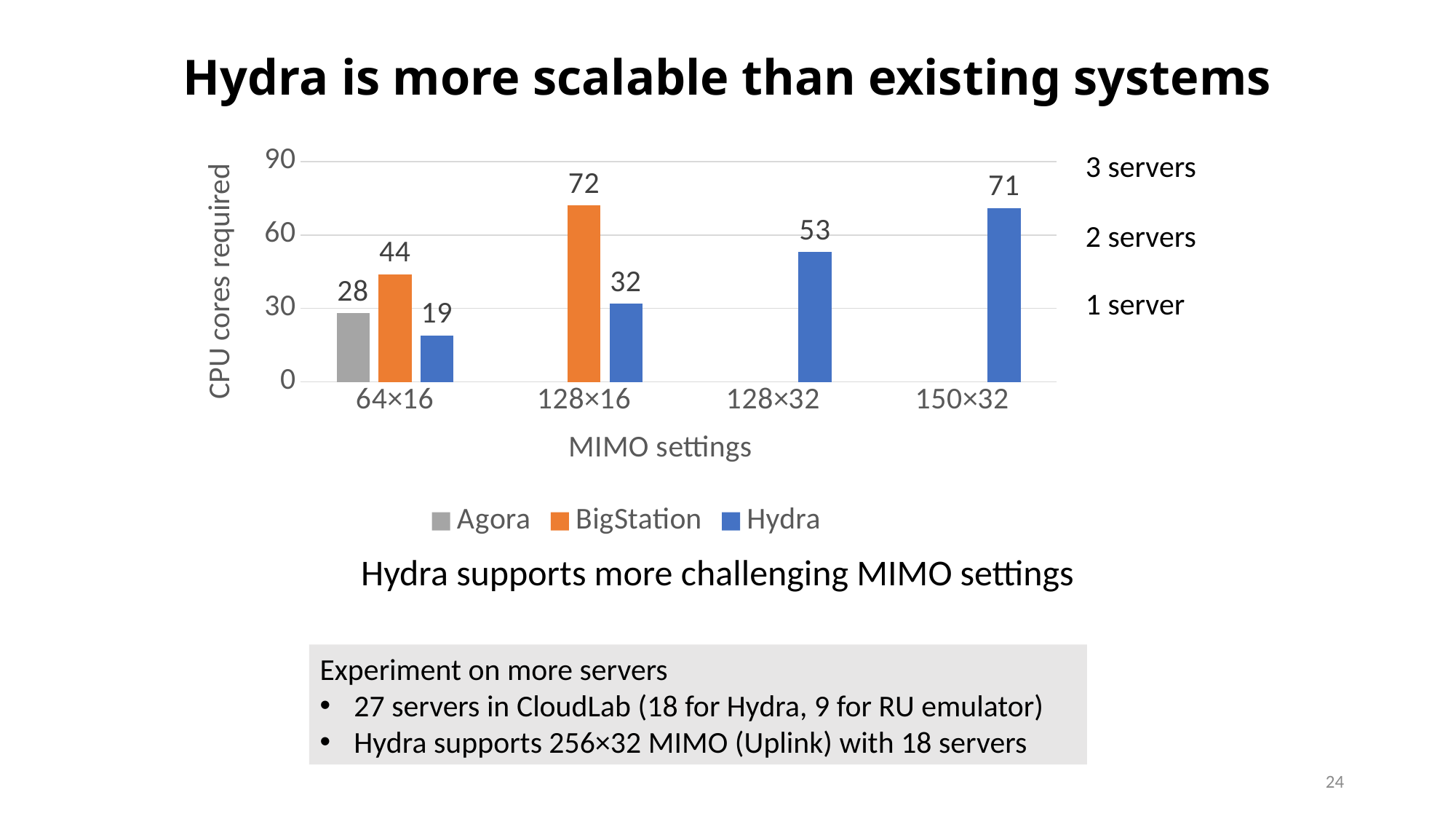
Which MIMO setting requires the most CPU cores for Hydra? 150×32 For the 64×16 setting, which system requires more CPU cores, Agora or BigStation? BigStation How many CPU cores does Hydra require for the 150×32 MIMO setting? 71 How many MIMO settings are shown on the x axis? 4 What kind of chart is shown on the slide? Bar chart How many series does the legend list? 3 How many CPU cores does Hydra require for the 64×16 MIMO setting? 19 How many CPU cores does BigStation require for the 128×16 MIMO setting? 72 How many CPU cores does Agora require for the 64×16 MIMO setting? 28 Do the CPU cores required for Hydra rise or fall as the MIMO settings move from 64×16 to 150×32? Rise What is the difference in CPU cores required between BigStation and Hydra for the 128×16 setting? 40 Which MIMO setting requires the fewest CPU cores for Hydra? 64×16